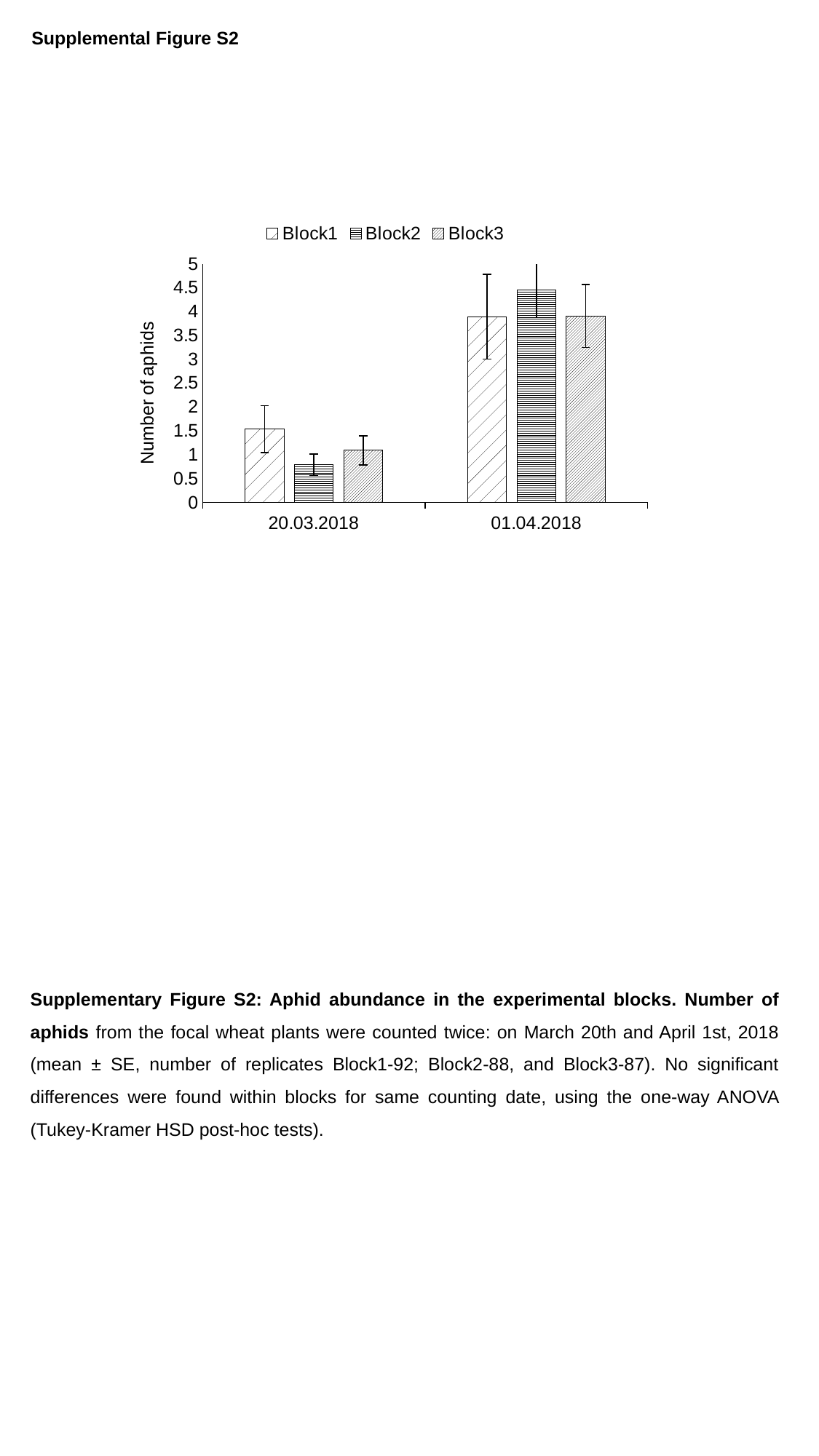
How many series does the legend list? 3 Which block has the lowest value on 20.03.2018? Block2 Which block has the highest value on 01.04.2018? Block2 Is the value for Block2 on 01.04.2018 greater or less than 4? greater What is the title of the y axis? Number of aphids What kind of chart is shown on the slide? bar chart What are the three series named in the legend? Block1, Block2, Block3 Is the value for Block1 on 01.04.2018 greater or less than 3? greater How many counting dates are shown on the x axis? 2 Do the values for Block3 rise or fall from 20.03.2018 to 01.04.2018? rise Is the value for Block1 on 20.03.2018 greater or less than 1? greater